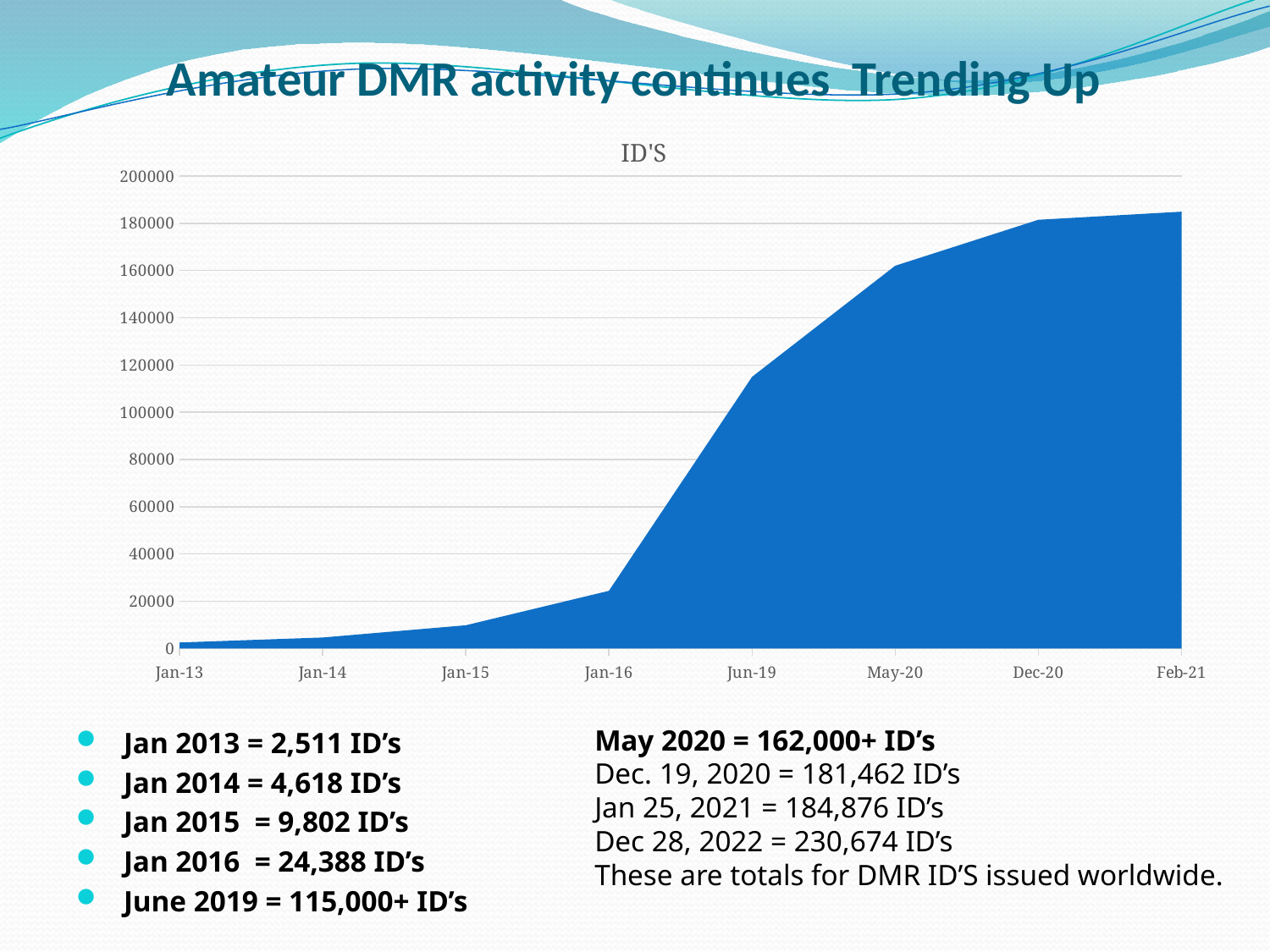
Do the values in the chart rise or fall from Jan-13 to Feb-21? Rise Is the value for Jan-16 greater or less than 40000? less Which x-axis category has the lowest value in the chart? Jan-13 Is the value for Jan-15 greater or less than 20000? less What kind of chart is shown on the slide? Area chart Is the value for Jun-19 greater or less than 100000? greater What is the highest value shown on the chart's y axis? 200000 Which has the larger value, Jan-16 or Jun-19? Jun-19 Which x-axis category has the highest value in the chart? Feb-21 What is the title of the chart? ID'S How many points are plotted along the x axis of the chart? 8